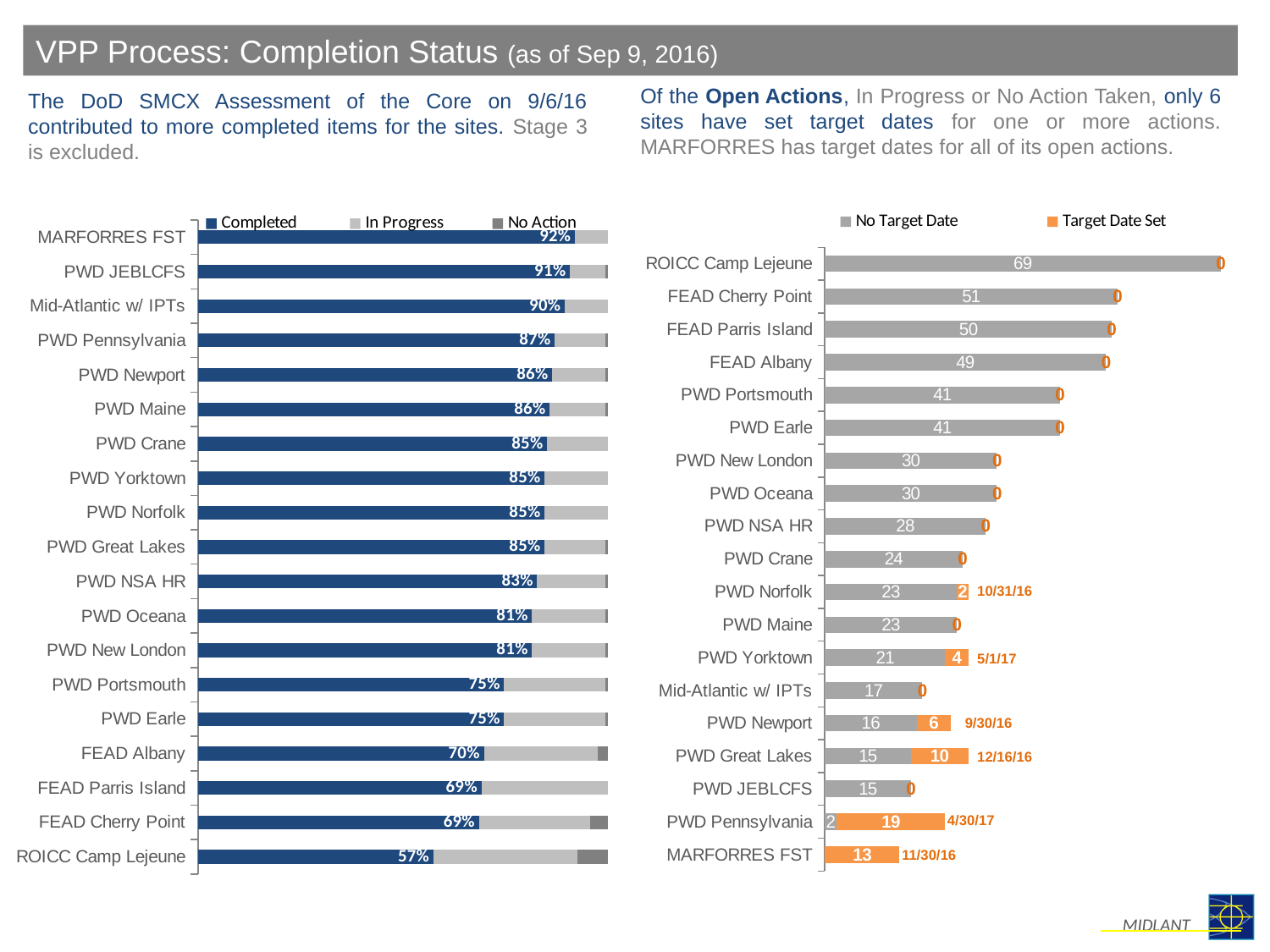
In the right chart, how many actions with a Target Date Set does PWD Great Lakes have? 10 In the right chart, how many open actions with No Target Date does FEAD Cherry Point have? 51 In the left chart, how many series does the legend list? 3 In the left chart, what is the Completed percentage for PWD Pennsylvania? 87% How many sites are listed in the right chart? 19 In the right chart, what is the difference between the No Target Date counts of PWD Portsmouth and PWD Yorktown? 20 In the right chart, which site has the most open actions with No Target Date? ROICC Camp Lejeune In the right chart, which site has more actions with a Target Date Set, PWD Pennsylvania or MARFORRES FST? PWD Pennsylvania In the left chart, what is the difference between the Completed percentages of MARFORRES FST and ROICC Camp Lejeune? 35% What type of chart is the right chart? Bar chart In the left chart, which site has the highest Completed percentage? MARFORRES FST In the left chart, which site has the lowest Completed percentage? ROICC Camp Lejeune